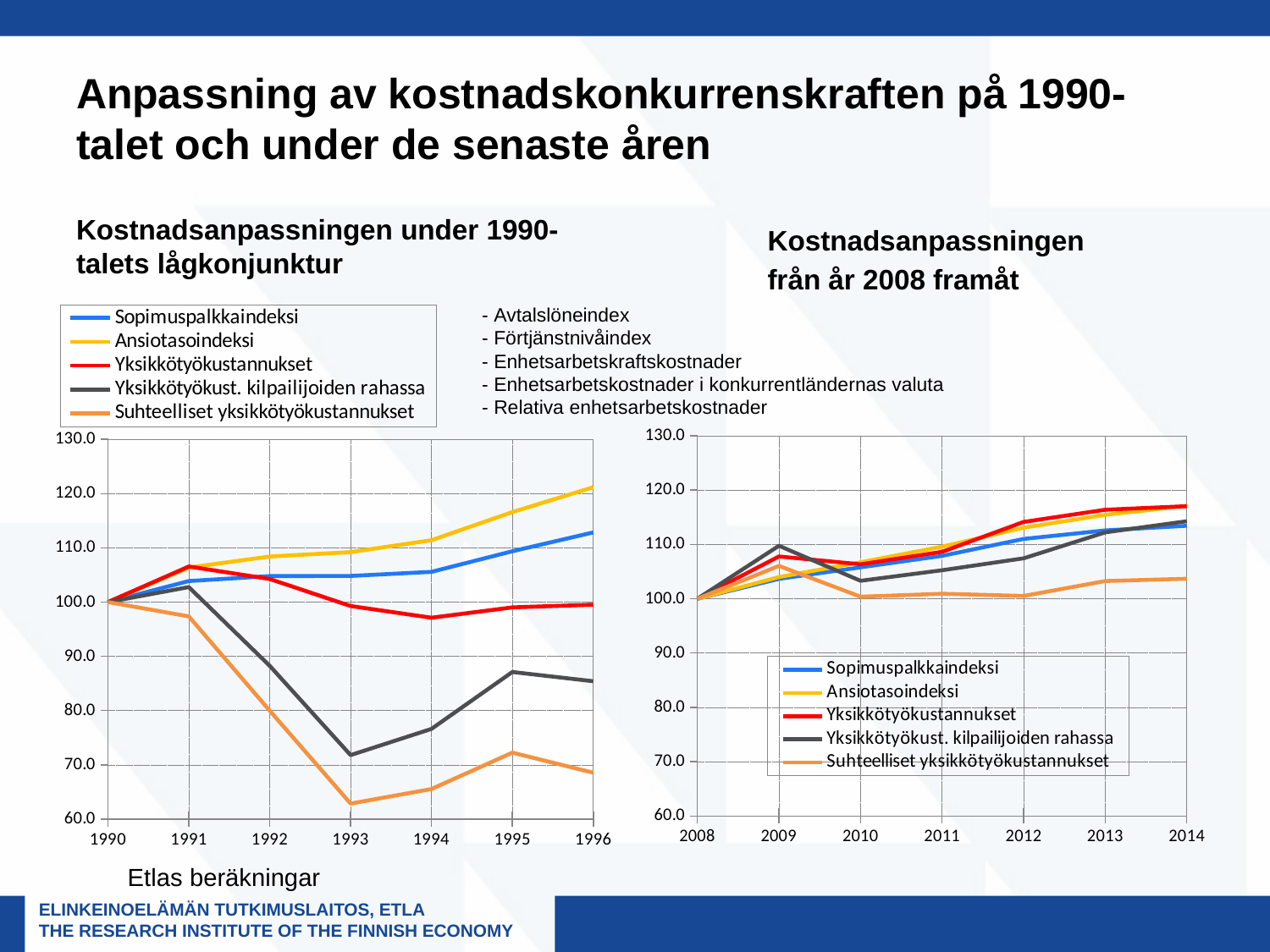
In the left chart, 'Kostnadsanpassningen under 1990-talets lågkonjunktur', is the value for Suhteelliset yksikkötyökustannukset in 1993 greater or less than 70.0? less In the left chart, 'Kostnadsanpassningen under 1990-talets lågkonjunktur', does Suhteelliset yksikkötyökustannukset rise or fall from 1990 to 1993? Fall In the left chart, 'Kostnadsanpassningen under 1990-talets lågkonjunktur', which series has the lowest value in 1996? Suhteelliset yksikkötyökustannukset In the left chart, 'Kostnadsanpassningen under 1990-talets lågkonjunktur', which series has the highest value in 1996? Ansiotasoindeksi In the right chart, 'Kostnadsanpassningen från år 2008 framåt', is the value for Ansiotasoindeksi in 2014 greater or less than 110.0? greater In the left chart, 'Kostnadsanpassningen under 1990-talets lågkonjunktur', what is the value of Sopimuspalkkaindeksi in 1990? 100.0 How many series does the legend of the right chart, 'Kostnadsanpassningen från år 2008 framåt', list? 5 In the left chart, 'Kostnadsanpassningen under 1990-talets lågkonjunktur', is the value for Ansiotasoindeksi in 1996 greater or less than 120.0? greater In the right chart, 'Kostnadsanpassningen från år 2008 framåt', which is larger in 2009: Yksikkötyökust. kilpailijoiden rahassa or Sopimuspalkkaindeksi? Yksikkötyökust. kilpailijoiden rahassa How many years are shown on the x axis of the left chart, 'Kostnadsanpassningen under 1990-talets lågkonjunktur'? 7 In the right chart, 'Kostnadsanpassningen från år 2008 framåt', which series has the lowest value in 2014? Suhteelliset yksikkötyökustannukset What kind of chart is the left chart, 'Kostnadsanpassningen under 1990-talets lågkonjunktur'? Line chart